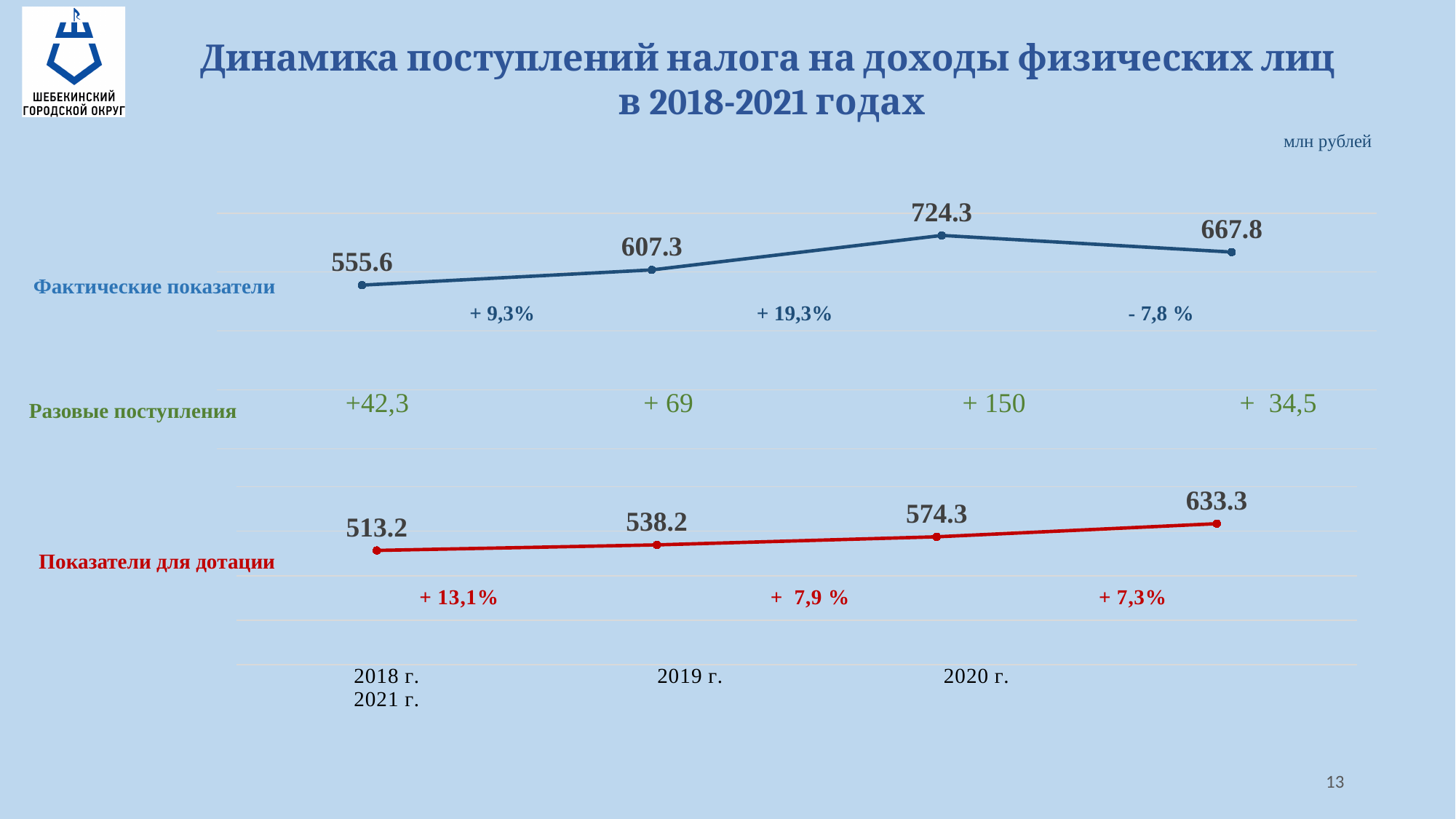
How many data points does the Показатели для дотации line have? 4 What is the difference between Фактические показатели and Показатели для дотации in 2019? 69.1 What is the value of Фактические показатели for 2018? 555.6 What type of chart is shown on the slide? Line chart What unit is indicated for the values on the chart? млн рублей In which year is Фактические показатели highest? 2020 Does the Показатели для дотации line rise or fall from 2018 to 2021? Rises What is the value of Фактические показатели for 2020? 724.3 What is the value of Показатели для дотации for 2021? 633.3 Which is larger in 2021: Фактические показатели or Показатели для дотации? Фактические показатели What percentage change is shown for Фактические показатели between 2020 and 2021? - 7,8 % In which year is Показатели для дотации lowest? 2018